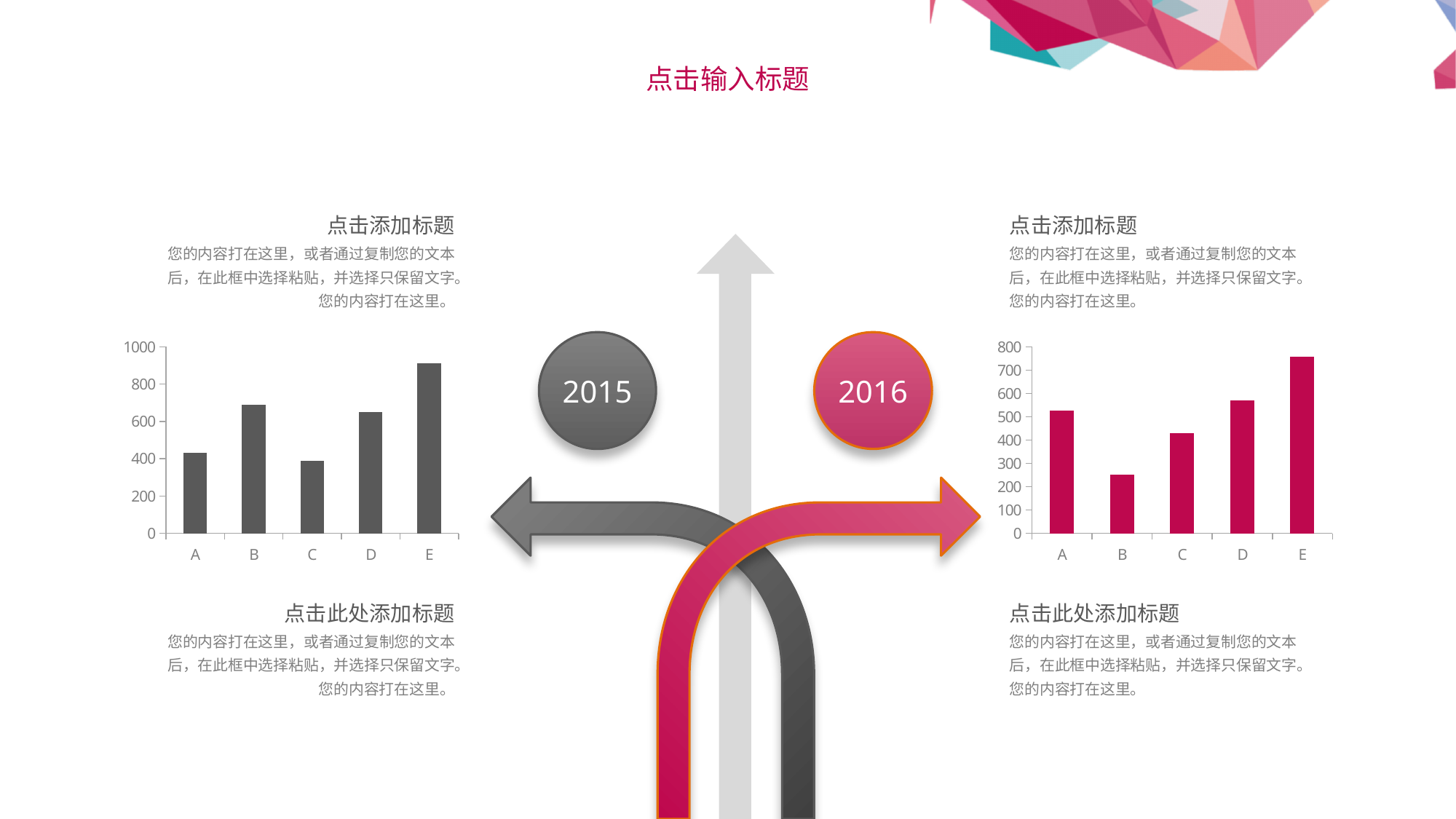
What colour are the bars in the right chart (next to 2016)? pink/red In the right chart (next to 2016), which category has the lowest bar? B In the left chart (next to 2015), which is larger, the value for B or the value for D? B In the right chart (next to 2016), which is larger, the value for A or the value for C? A In the right chart (next to 2016), is the value for B greater or less than 300? less In the left chart (next to 2015), which category has the lowest bar? C In the right chart (next to 2016), which category has the highest bar? E How many categories does the left chart (next to 2015) show? 5 What kind of chart is the left chart (next to 2015)? bar chart In the left chart (next to 2015), is the value for E greater or less than 800? greater In the left chart (next to 2015), which category has the highest bar? E In the left chart (next to 2015), is the value for A greater or less than 600? less